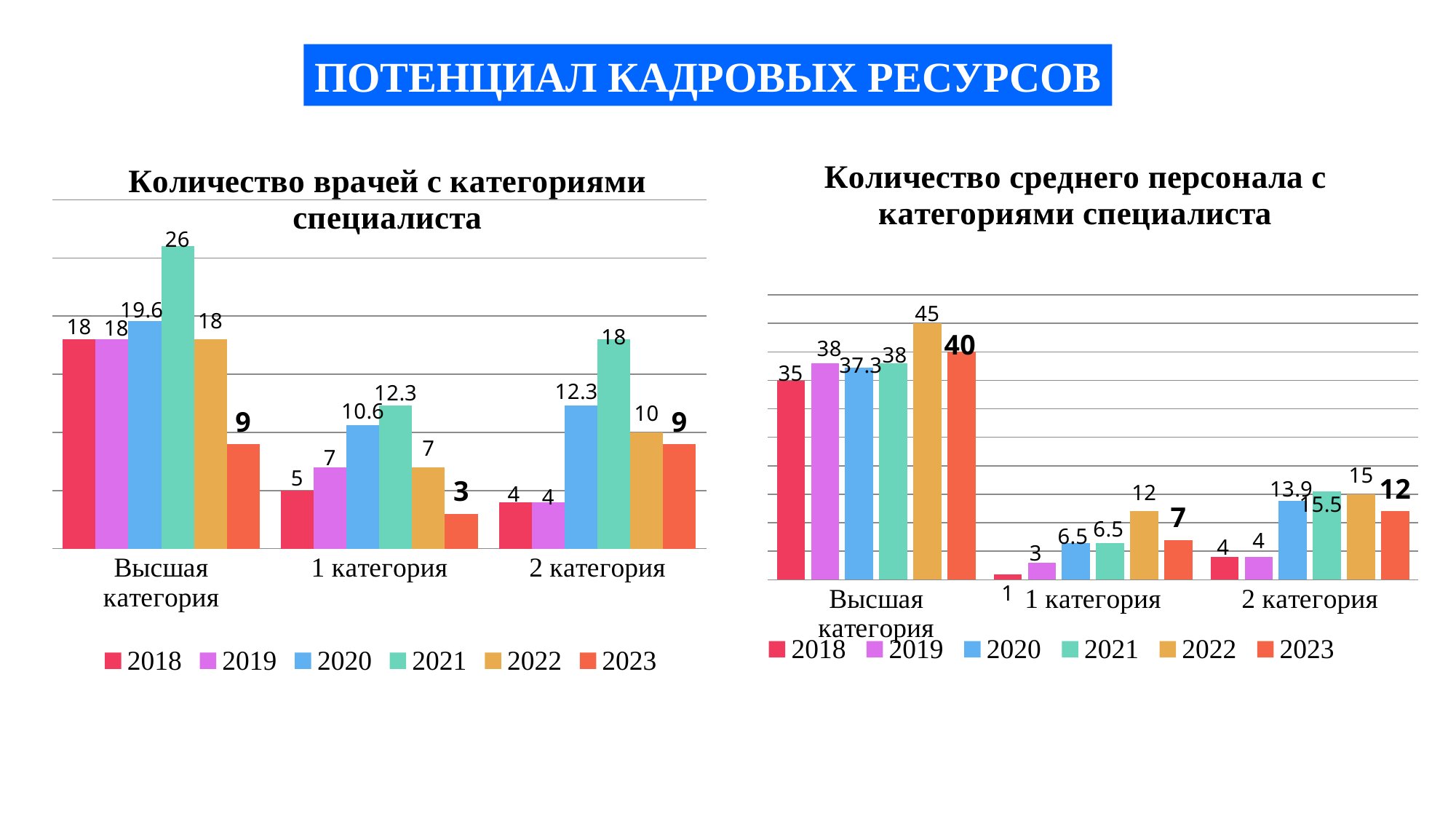
In the chart 'Количество врачей с категориями специалиста', what is the value for 2023 in the '1 категория' group? 3 In the chart 'Количество врачей с категориями специалиста', what is the difference between the 2021 and 2023 values in the 'Высшая категория' group? 17 In the chart 'Количество среднего персонала с категориями специалиста', what is the value for 2018 in the '1 категория' group? 1 What type of chart is 'Количество врачей с категориями специалиста'? Bar chart In the chart 'Количество среднего персонала с категориями специалиста', what is the value for 2022 in the 'Высшая категория' group? 45 In the chart 'Количество среднего персонала с категориями специалиста', which year has the lowest value in the 'Высшая категория' group? 2018 In the chart 'Количество врачей с категориями специалиста', what is the value for 2021 in the 'Высшая категория' group? 26 How many category groups are shown on the x axis of the chart 'Количество среднего персонала с категориями специалиста'? 3 In the chart 'Количество среднего персонала с категориями специалиста', what is the difference between the 2022 and 2023 values in the '1 категория' group? 5 In the chart 'Количество среднего персонала с категориями специалиста', which is larger in the '2 категория' group: the 2021 value or the 2022 value? 2021 In the chart 'Количество врачей с категориями специалиста', how many series does the legend list? 6 In the chart 'Количество врачей с категориями специалиста', which year has the highest value in the '2 категория' group? 2021